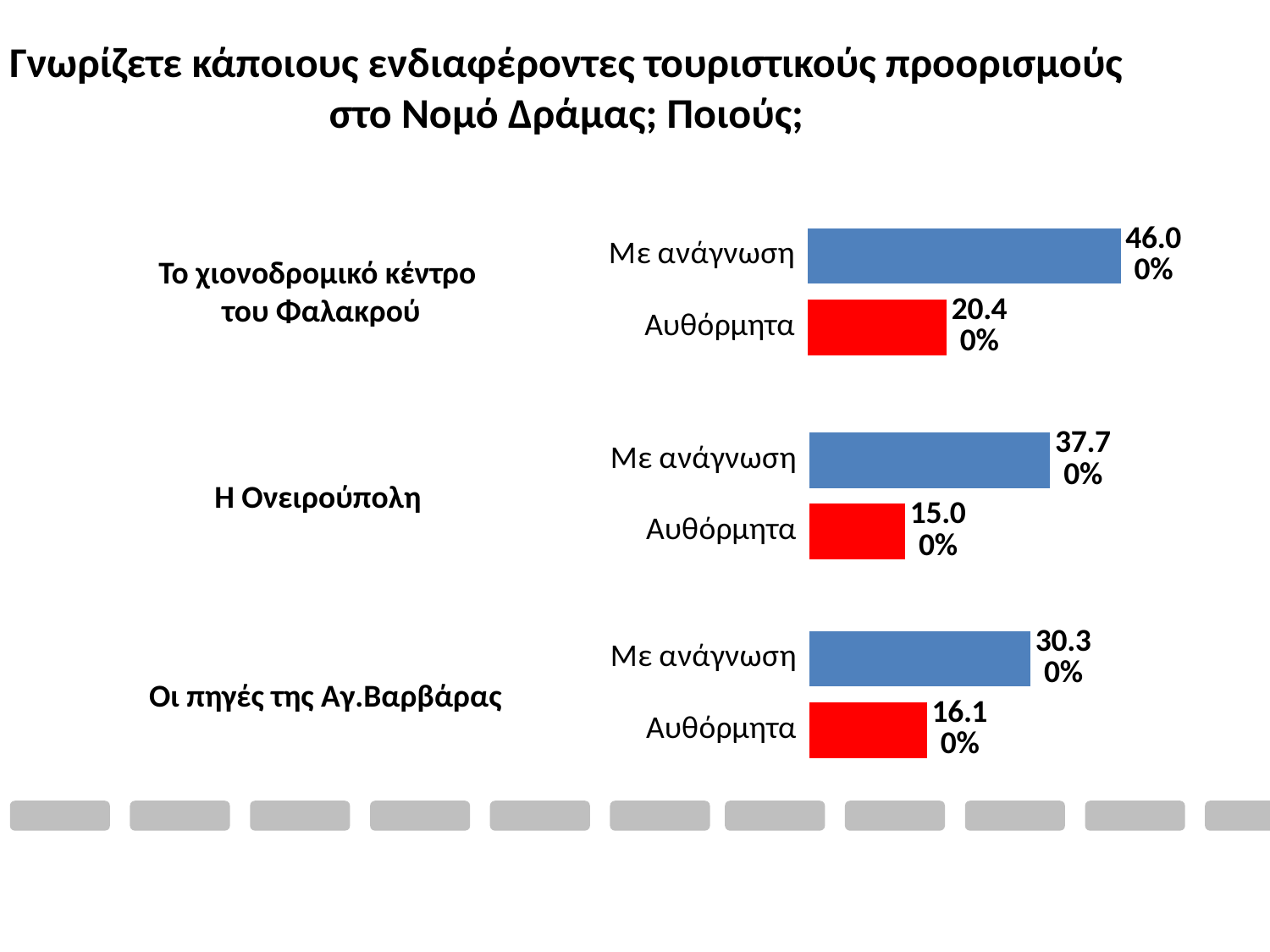
What colour are the 'Αυθόρμητα' bars? Red Which is larger: the 'Αυθόρμητα' value for 'Οι πηγές της Αγ.Βαρβάρας' or for 'Η Ονειρούπολη'? Οι πηγές της Αγ.Βαρβάρας What is the difference between the 'Με ανάγνωση' and 'Αυθόρμητα' values for 'Η Ονειρούπολη'? 22.70% What is the value of the 'Αυθόρμητα' bar for 'Η Ονειρούπολη'? 15.00% Which destination has the lowest 'Αυθόρμητα' value? Η Ονειρούπολη What kind of chart is shown on the slide? Bar chart What is the difference between the 'Με ανάγνωση' values for 'Το χιονοδρομικό κέντρο του Φαλακρού' and 'Οι πηγές της Αγ.Βαρβάρας'? 15.70% Which destination has the highest 'Με ανάγνωση' value? Το χιονοδρομικό κέντρο του Φαλακρού What is the value of the 'Με ανάγνωση' bar for 'Οι πηγές της Αγ.Βαρβάρας'? 30.30% What is the value of the 'Με ανάγνωση' bar for 'Το χιονοδρομικό κέντρο του Φαλακρού'? 46.00% How many destinations are shown in the chart? 3 What is the value of the 'Αυθόρμητα' bar for 'Το χιονοδρομικό κέντρο του Φαλακρού'? 20.40%